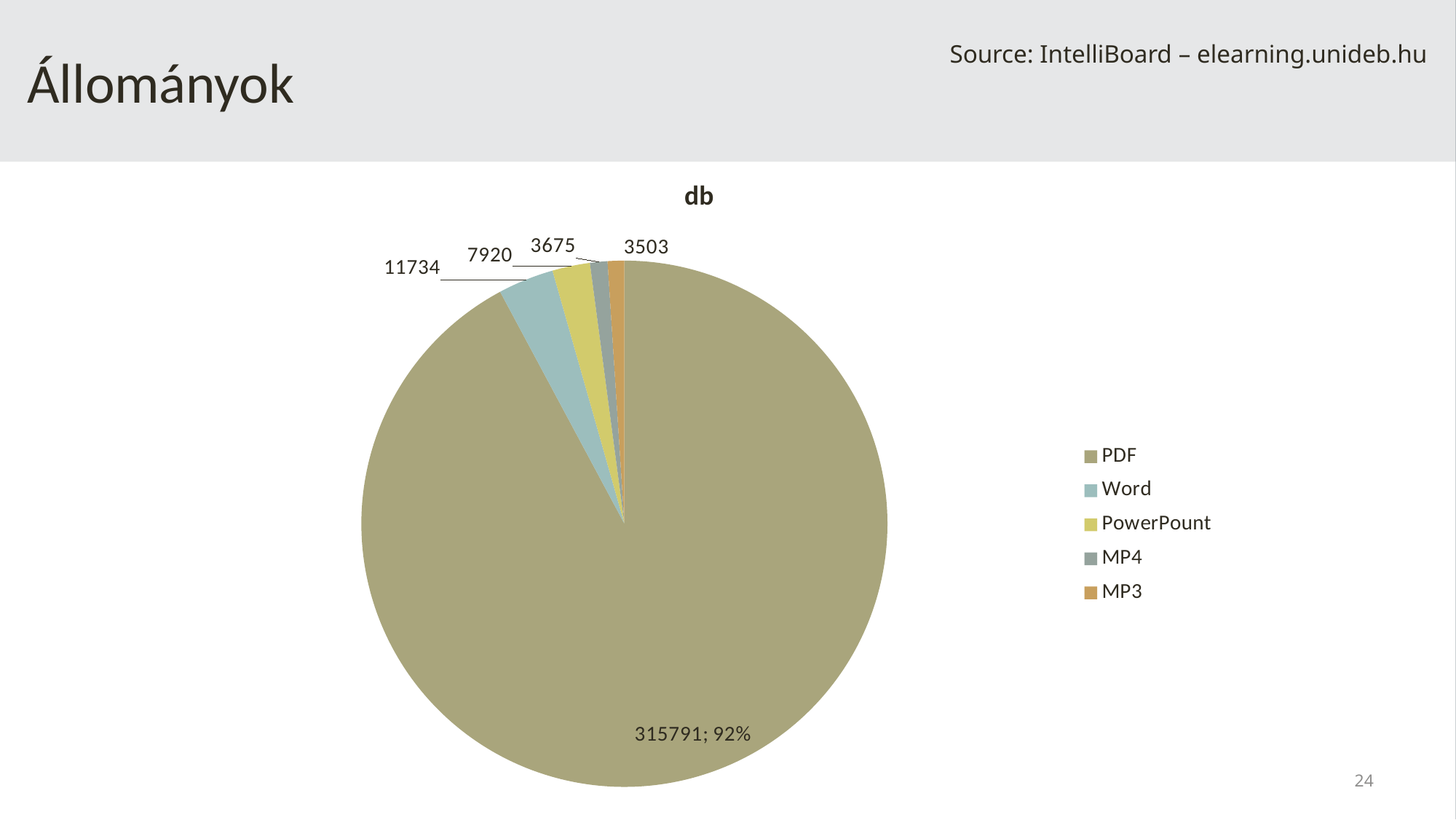
What kind of chart is shown on the slide? pie chart What is the value for MP3? 3503 What is the title of the chart? db Which category has the smallest slice? MP3 What is the value for Word? 11734 What share of the pie does PDF represent? 92% What is the value for MP4? 3675 What is the difference between the values for Word and PowerPount? 3814 Which category has the largest slice? PDF What is the value for PowerPount? 7920 What is the value for PDF? 315791 How many categories does the legend list? 5